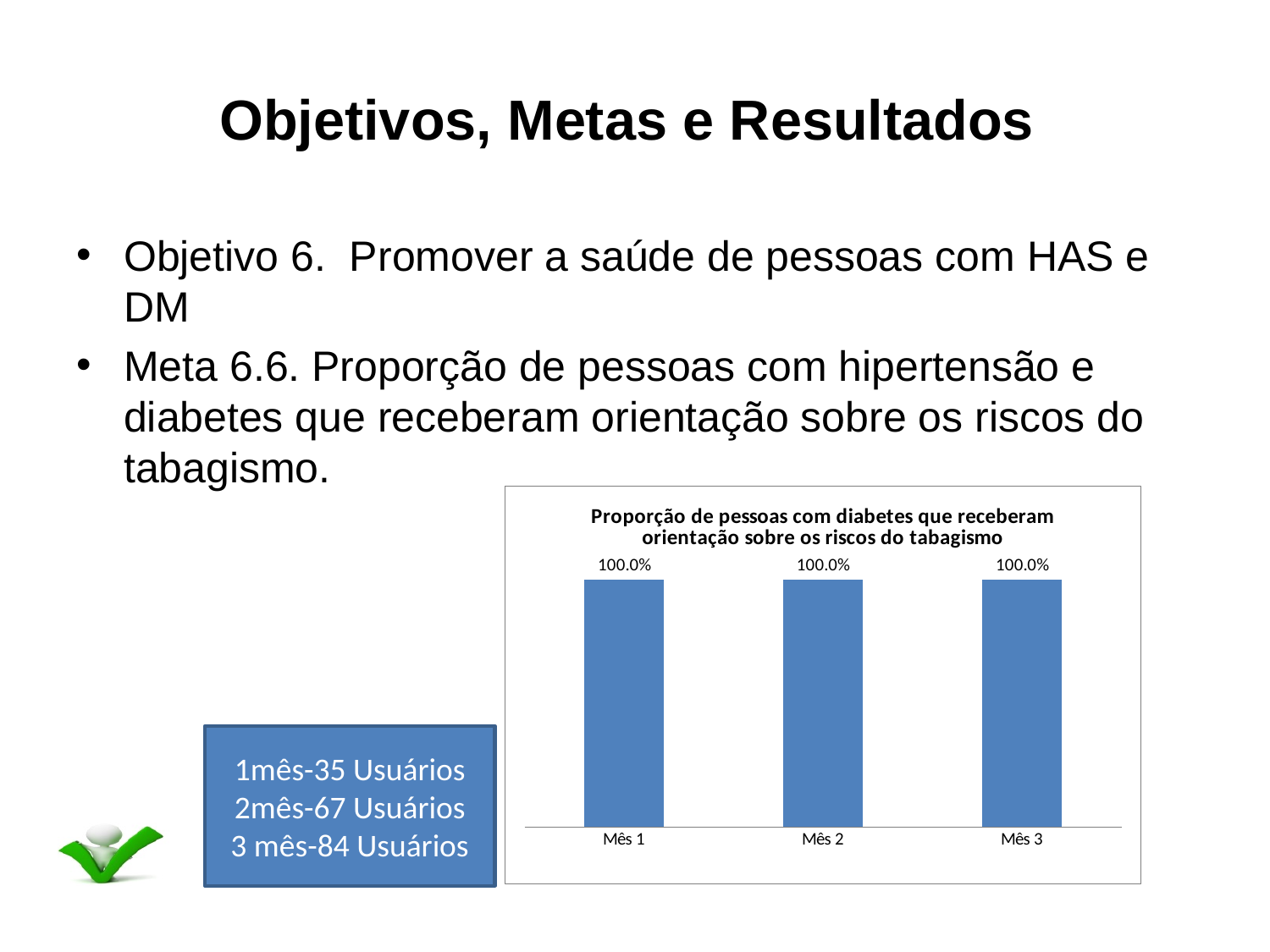
What is the value for Mês 1 in the chart? 100.0% What is the title of the chart? Proporção de pessoas com diabetes que receberam orientação sobre os riscos do tabagismo Do the values rise, fall, or stay the same from Mês 1 to Mês 3? Stay the same Is the value for Mês 2 larger than, smaller than, or equal to the value for Mês 1? Equal What kind of chart is shown on the slide? Bar chart How many categories (months) are shown on the x axis of the chart? 3 What colour are the bars in the chart? Blue What is the difference between the values for Mês 1 and Mês 3? 0.0% What is the value for Mês 2 in the chart? 100.0% What is the value for Mês 3 in the chart? 100.0%